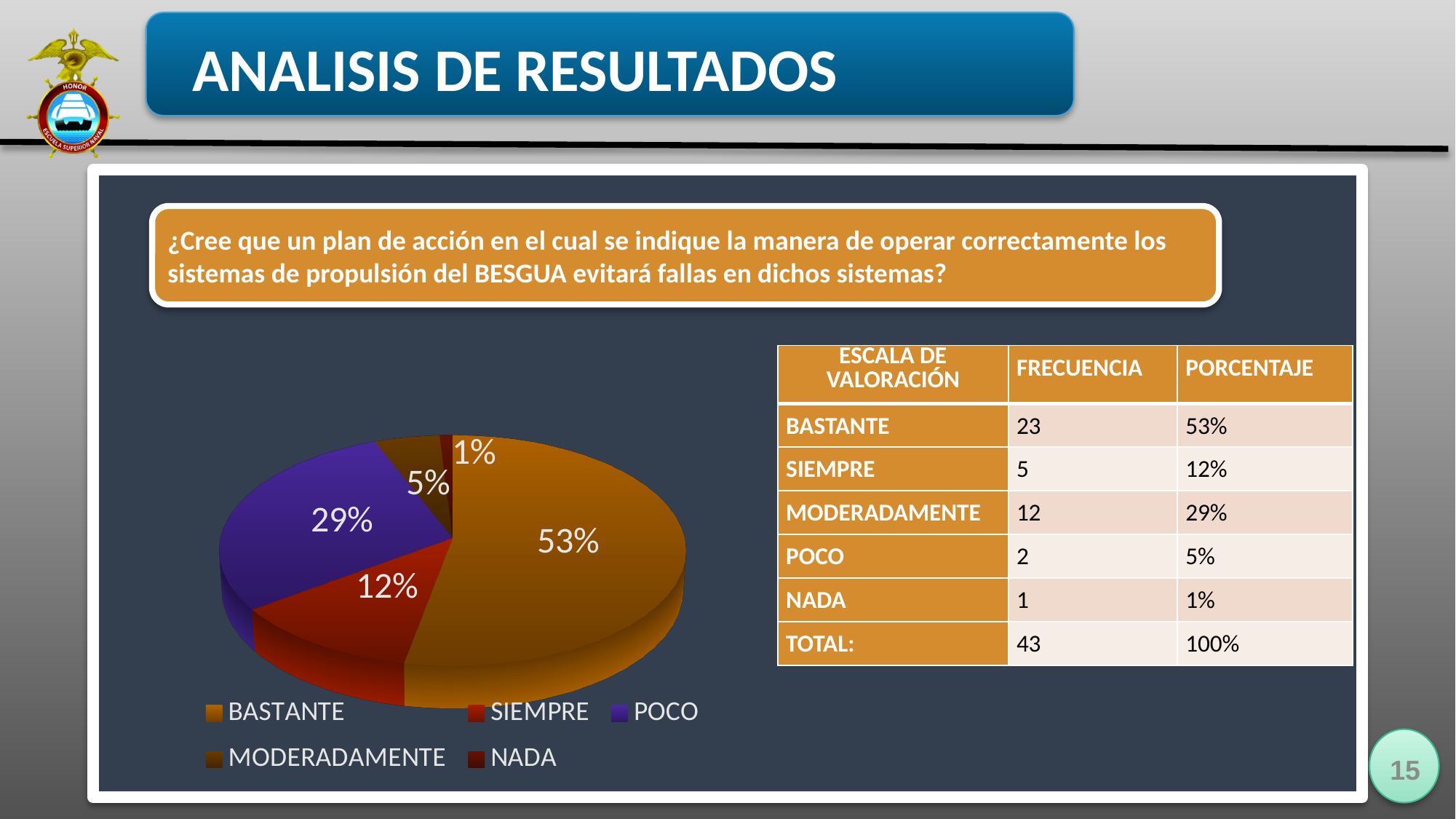
Which slice is larger in the pie chart, BASTANTE or SIEMPRE? BASTANTE What colour is the BASTANTE slice in the pie chart? orange What percentage does the pie chart show for NADA? 1% What percentage does the pie chart show for BASTANTE? 53% What percentage does the pie chart show for SIEMPRE? 12% What is the combined share of the BASTANTE and SIEMPRE slices? 65% By how many percentage points does the BASTANTE slice exceed the SIEMPRE slice? 41 How many entries does the pie chart's legend list? 5 Which category has the largest slice in the pie chart? BASTANTE What kind of chart is shown on the slide? pie chart How many slices does the pie chart have? 5 Which category has the smallest slice in the pie chart? NADA